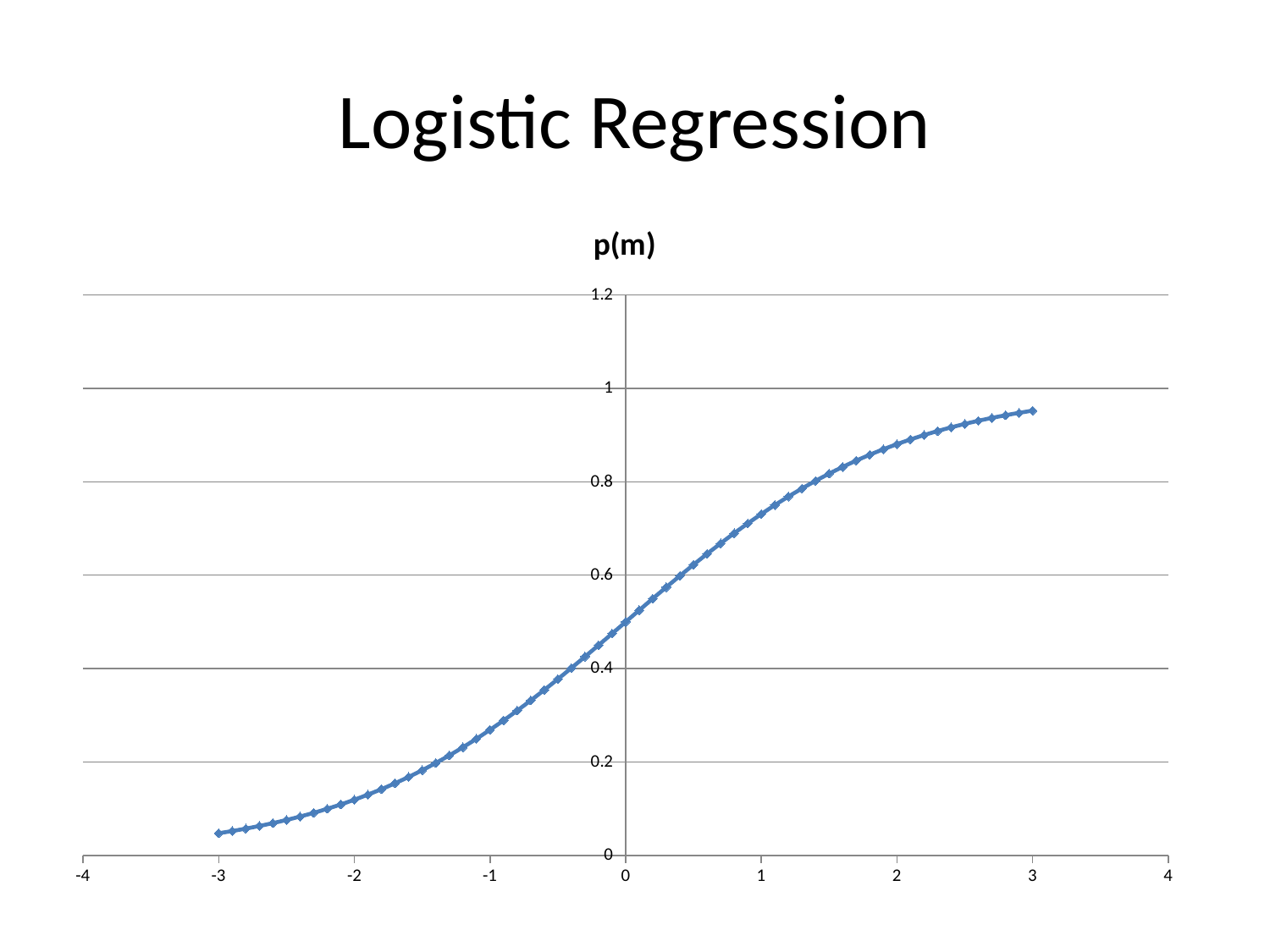
At which x value does the plotted curve reach its highest point? 3 Is the value of p(m) at x = 3 greater or less than 1? less What is the title of the chart? p(m) Is the value of p(m) at x = -3 greater or less than 0.2? less Do the plotted values rise or fall as the x axis goes from -3 to 3? rise Is the value of p(m) at x = 3 greater or less than 0.8? greater What kind of chart is shown on the slide? line chart At which x value does the plotted curve reach its lowest point? -3 Which is larger, the value of p(m) at x = 2 or at x = -2? x = 2